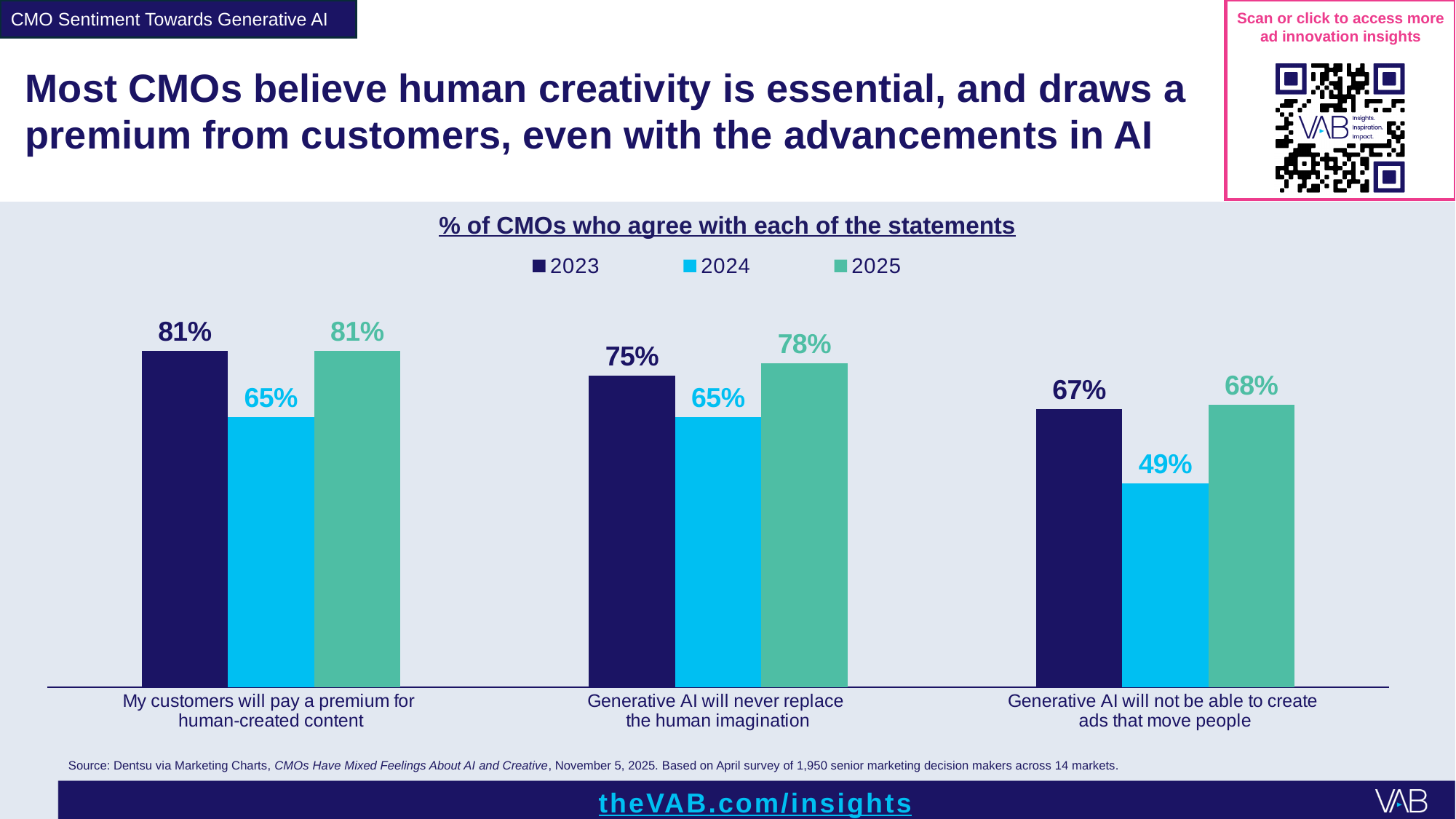
What type of chart is shown on the slide? Bar chart Which statement had the lowest share of agreement in 2024? Generative AI will not be able to create ads that move people Which statement had the highest share of agreement in 2025? My customers will pay a premium for human-created content What is the title of the chart? % of CMOs who agree with each of the statements What is the difference between the 2025 and 2024 values for 'Generative AI will not be able to create ads that move people'? 19 percentage points What is the difference between the 2023 and 2024 values for 'My customers will pay a premium for human-created content'? 16 percentage points How many statements (categories) are shown on the chart? 3 What percentage of CMOs agreed in 2023 that their customers will pay a premium for human-created content? 81% What percentage of CMOs agreed in 2025 that generative AI will never replace the human imagination? 78% For 'Generative AI will never replace the human imagination', which year had the larger value, 2023 or 2025? 2025 What percentage of CMOs agreed in 2024 that generative AI will not be able to create ads that move people? 49% How many series does the legend list? 3